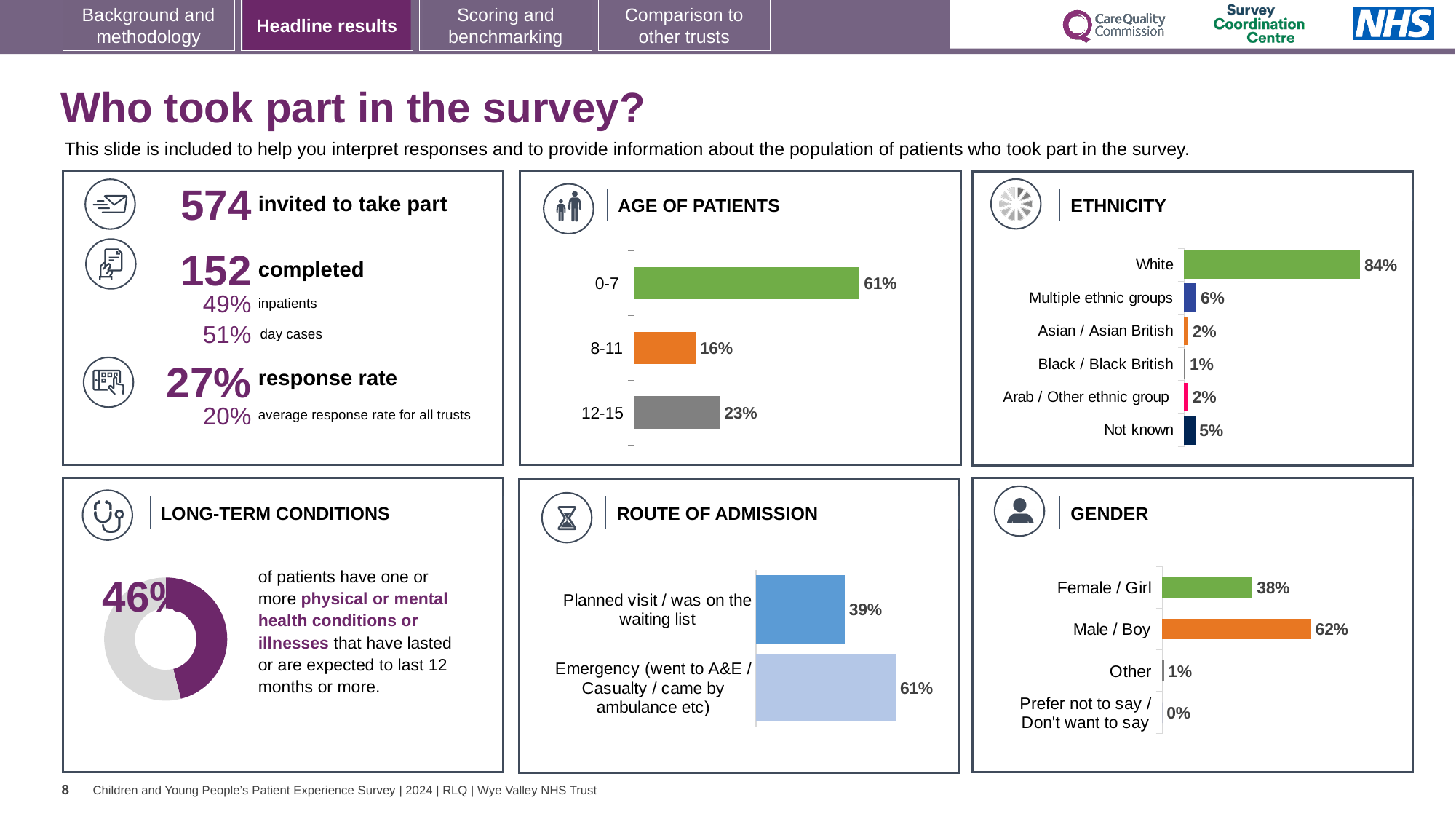
In the ROUTE OF ADMISSION chart, what percentage of patients came via Emergency (went to A&E / Casualty / came by ambulance etc)? 61% In the AGE OF PATIENTS chart, what percentage of patients were aged 0-7? 61% In the AGE OF PATIENTS chart, what is the difference between the 12-15 and 8-11 percentages? 7% In the GENDER chart, what is the difference between the Male / Boy and Female / Girl percentages? 24% In the ETHNICITY chart, what percentage of patients were White? 84% What kind of chart is used in the LONG-TERM CONDITIONS panel? Doughnut chart In the ETHNICITY chart, which category has the lowest percentage? Black / Black British In the GENDER chart, what percentage of patients were Male / Boy? 62% In the ROUTE OF ADMISSION chart, which route has the larger percentage: Planned visit / was on the waiting list or Emergency? Emergency (went to A&E / Casualty / came by ambulance etc) In the ETHNICITY chart, how many ethnicity categories are shown? 6 In the ETHNICITY chart, what percentage is shown for Not known? 5% In the AGE OF PATIENTS chart, which age group has the lowest percentage? 8-11